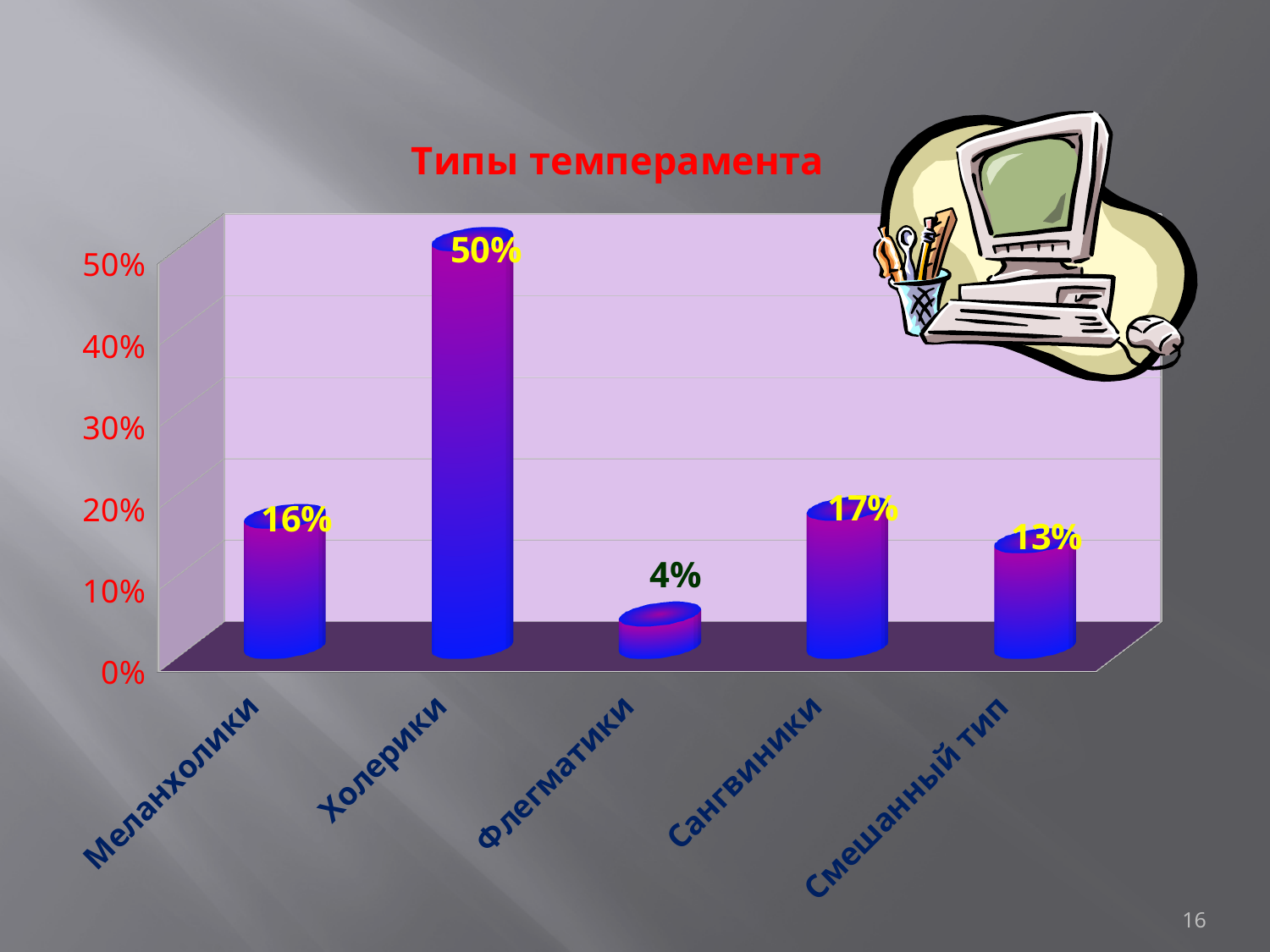
Which category has the highest value? Холерики What is the value for Смешанный тип? 13% What is the value for Флегматики? 4% Which is larger, the value for Сангвиники or the value for Смешанный тип? Сангвиники Is the value for Меланхолики greater or less than 20%? less Which category has the lowest value? Флегматики What is the value for Меланхолики? 16% What is the title of the chart? Типы темперамента What is the difference between the values for Холерики and Сангвиники? 33% What kind of chart is shown on the slide? bar chart How many categories are shown on the chart? 5 What is the value for Холерики? 50%